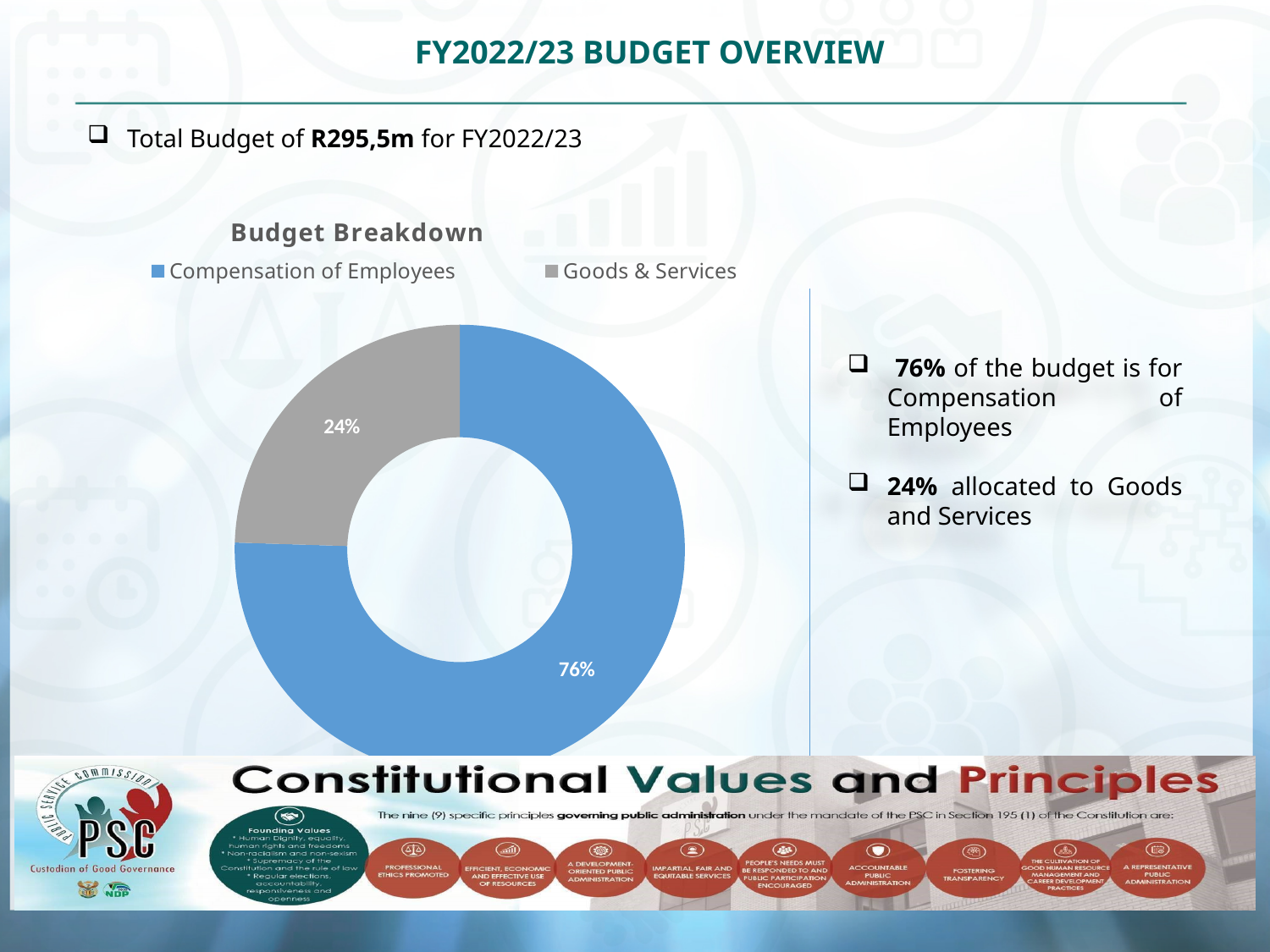
What share of the Budget Breakdown chart is Compensation of Employees? 76% What is the difference in percentage points between Compensation of Employees and Goods & Services in the Budget Breakdown chart? 52 What is the title of the chart on the slide? Budget Breakdown Which is larger in the Budget Breakdown chart, Compensation of Employees or Goods & Services? Compensation of Employees What kind of chart is the Budget Breakdown chart? Doughnut (pie) chart How many categories are shown in the Budget Breakdown chart? 2 What share of the Budget Breakdown chart is Goods & Services? 24% What is the total of the two shares shown in the Budget Breakdown chart? 100% Which category has the smallest share in the Budget Breakdown chart? Goods & Services Which category has the largest share in the Budget Breakdown chart? Compensation of Employees What colour represents Goods & Services in the Budget Breakdown chart? Grey How many entries does the legend of the Budget Breakdown chart list? 2